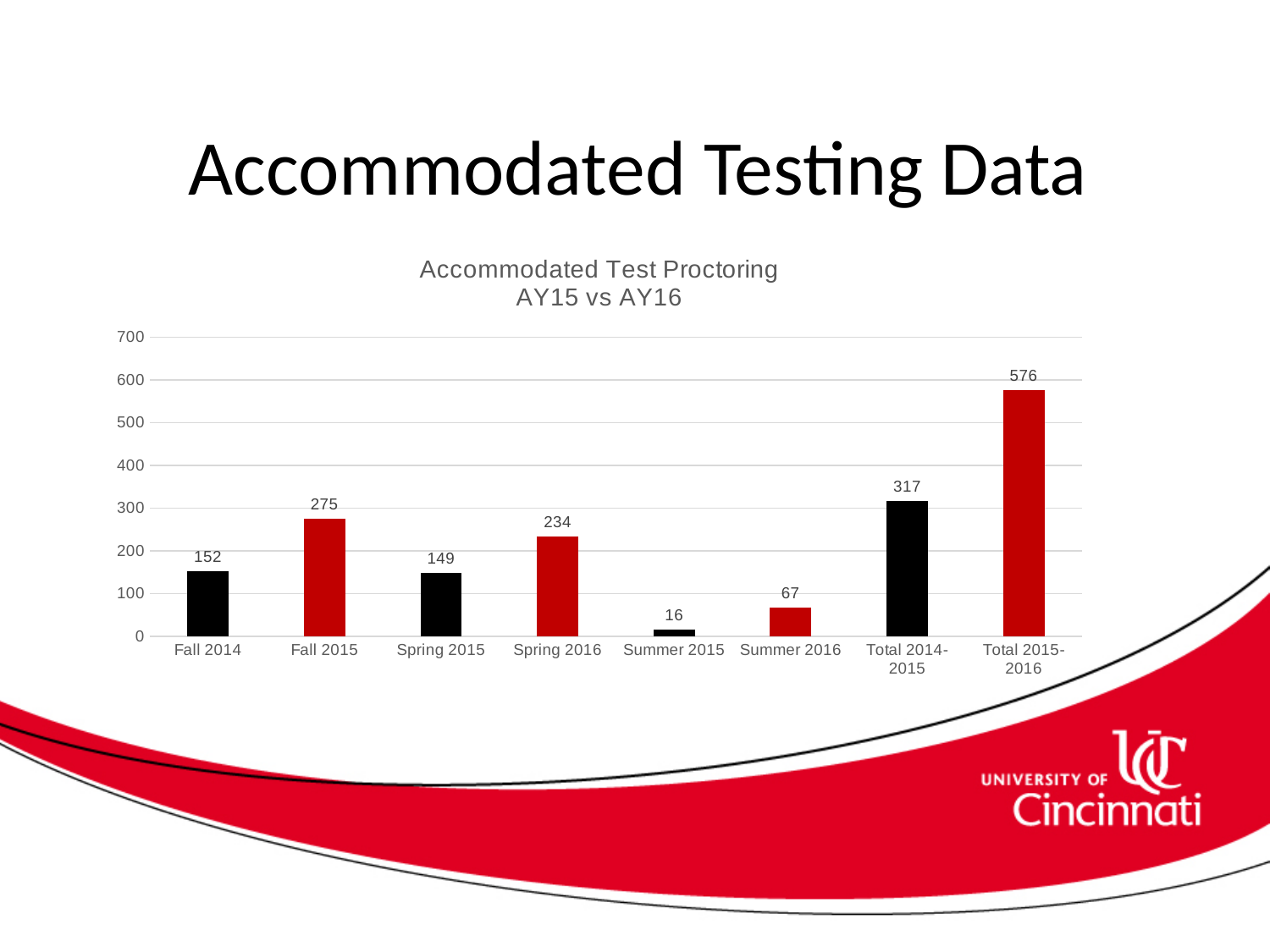
How many categories are shown on the x axis? 8 Is the value for Summer 2016 greater or less than 100? less What is the title of the chart? Accommodated Test Proctoring AY15 vs AY16 Which is larger, Fall 2014 or Spring 2015? Fall 2014 What is the value for Summer 2015? 16 What is the value for Fall 2015? 275 What is the difference between Total 2015-2016 and Total 2014-2015? 259 What kind of chart is this? bar chart What is the value for Total 2014-2015? 317 Which category has the lowest value? Summer 2015 Which category has the highest value? Total 2015-2016 What is the difference between Spring 2016 and Spring 2015? 85